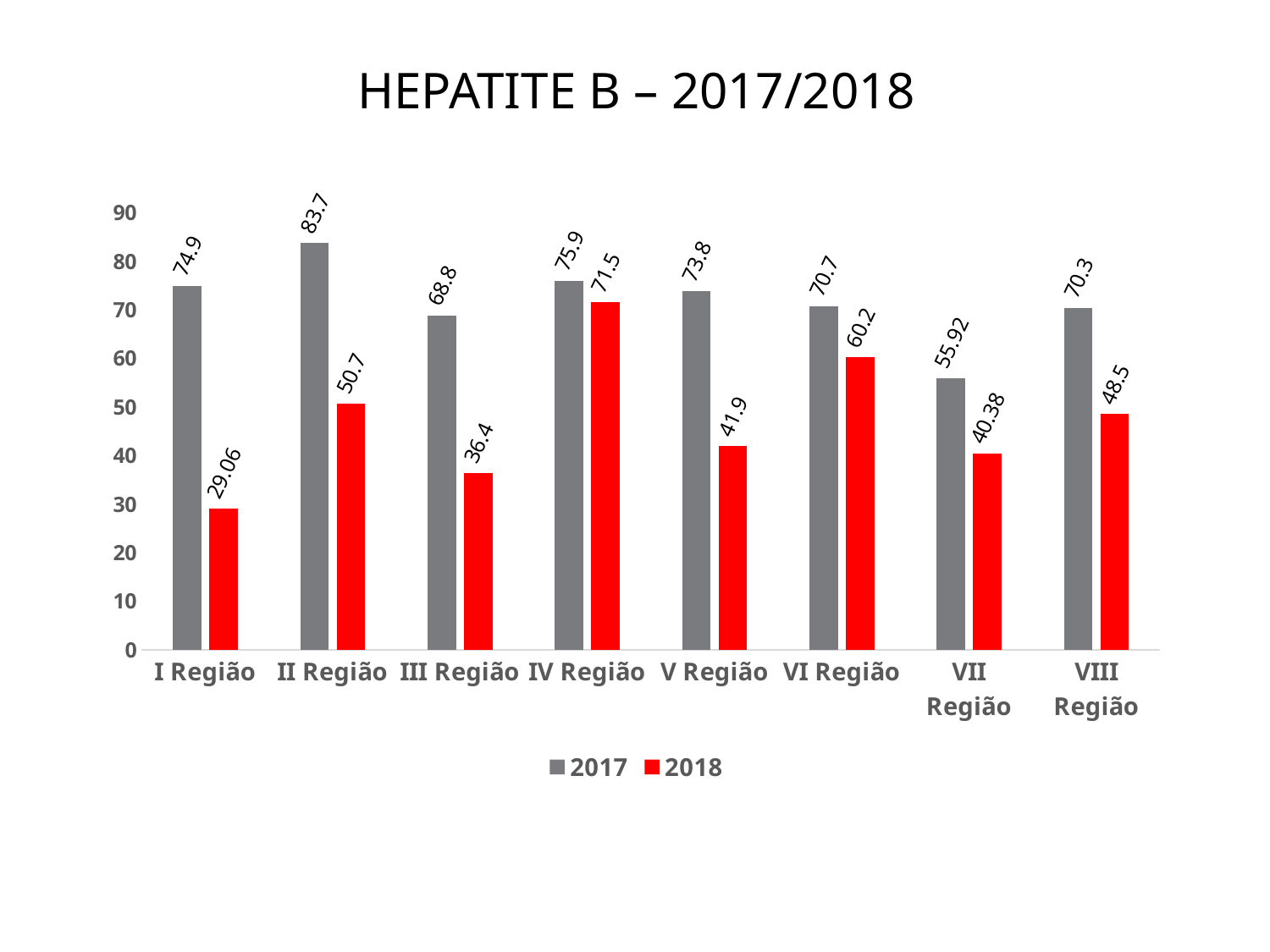
How many regions are shown on the x axis? 8 What is the difference between the 2017 and 2018 values for IV Região? 4.4 Is the 2017 value for VII Região greater or less than 60? less What colour are the 2018 bars? red Which region has the highest 2017 value? II Região Which region has the lowest 2018 value? I Região What is the 2017 value for II Região? 83.7 What is the 2018 value for VII Região? 40.38 What is the 2018 value for I Região? 29.06 How many series does the legend list? 2 What kind of chart is shown on the slide? bar chart Which is larger, the 2018 value for VI Região or the 2018 value for VIII Região? VI Região